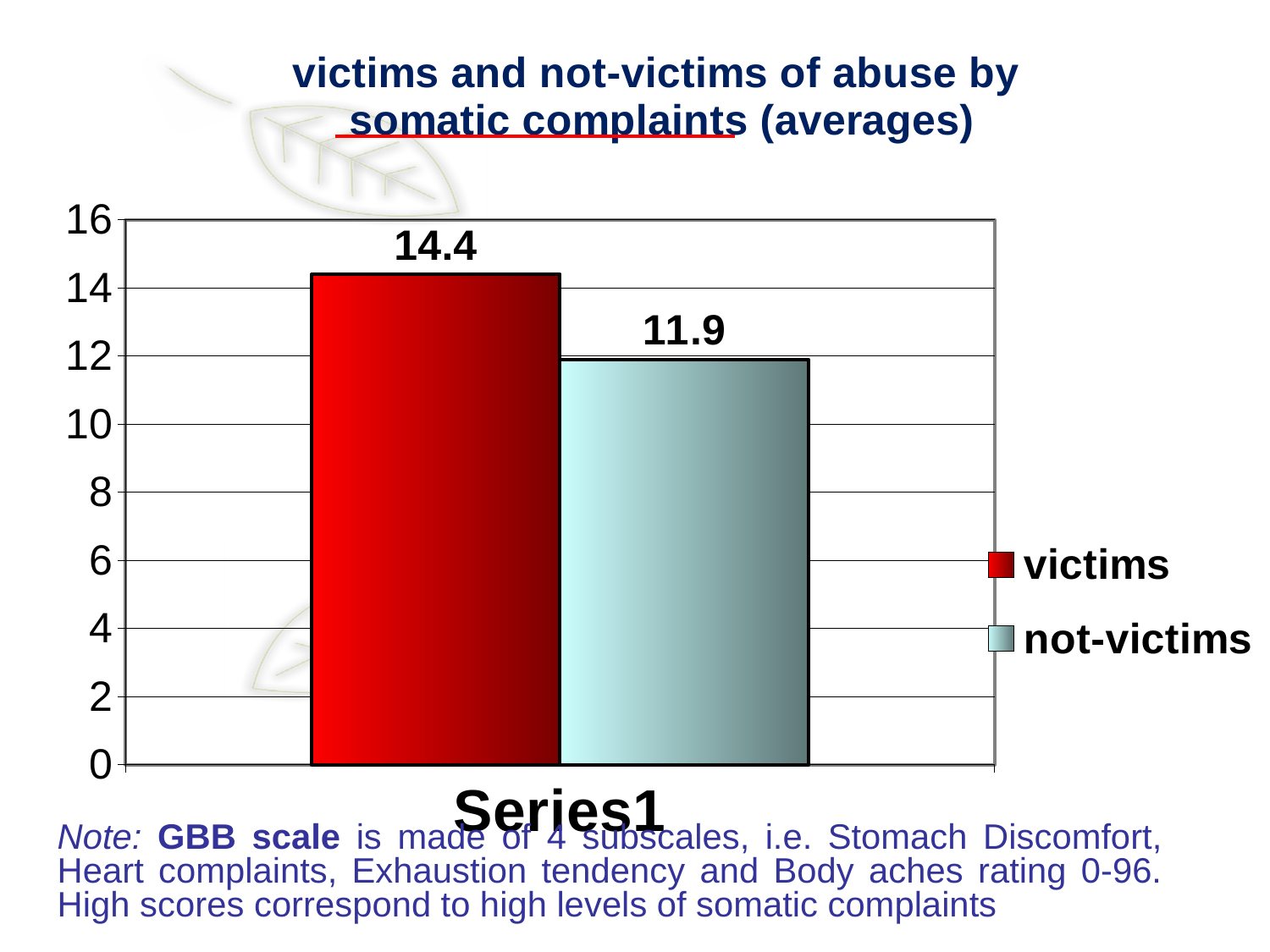
What colour is the bar for victims? red What is the value for victims? 14.4 Is the value for victims greater or less than 14? greater What is the value for not-victims? 11.9 How many series does the legend list? 2 Which series has the higher value, victims or not-victims? victims What is the difference between the values for victims and not-victims? 2.5 Is the value for not-victims greater or less than 12? less Which series has the lowest value? not-victims What kind of chart is shown on the slide? bar chart What is the maximum value shown on the vertical axis? 16